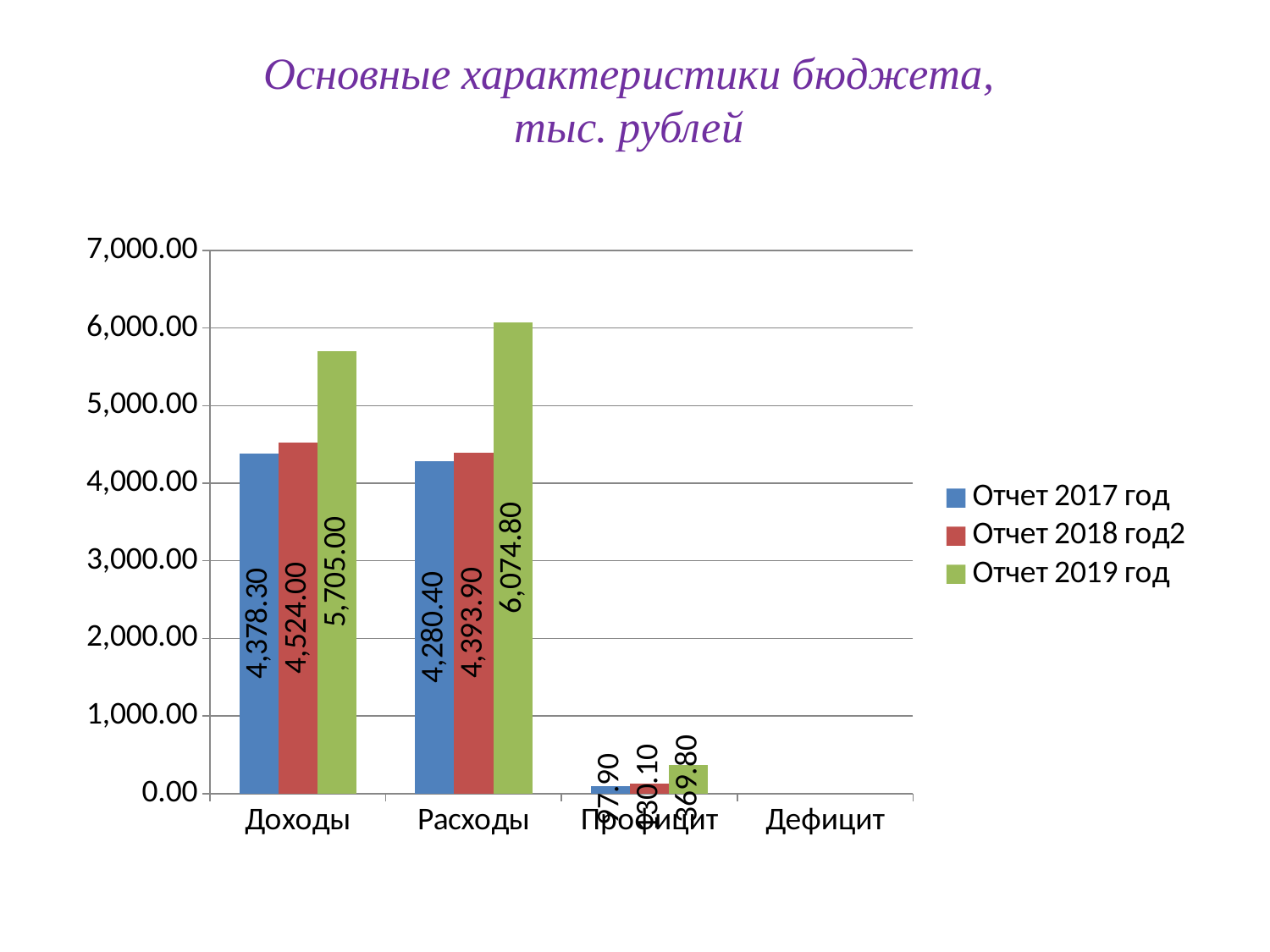
Which category has the highest value in the Отчет 2019 год series? Расходы What is the value for Профицит in the Отчет 2019 год series? 369.80 What is the difference between the Отчет 2019 год and Отчет 2017 год values for Доходы? 1,326.70 What is the value for Расходы in the Отчет 2017 год series? 4,280.40 What type of chart is shown on the slide? Bar chart How many series does the legend list? 3 Which is larger: Доходы in Отчет 2017 год or Доходы in Отчет 2018 год2? Доходы in Отчет 2018 год2 Is the value for Расходы in the Отчет 2019 год series greater or less than 6,000.00? greater What is the value for Доходы in the Отчет 2018 год2 series? 4,524.00 What is the value for Доходы in the Отчет 2019 год series? 5,705.00 How many categories are shown on the x axis? 4 What is the difference between Расходы and Доходы in the Отчет 2018 год2 series? 130.10